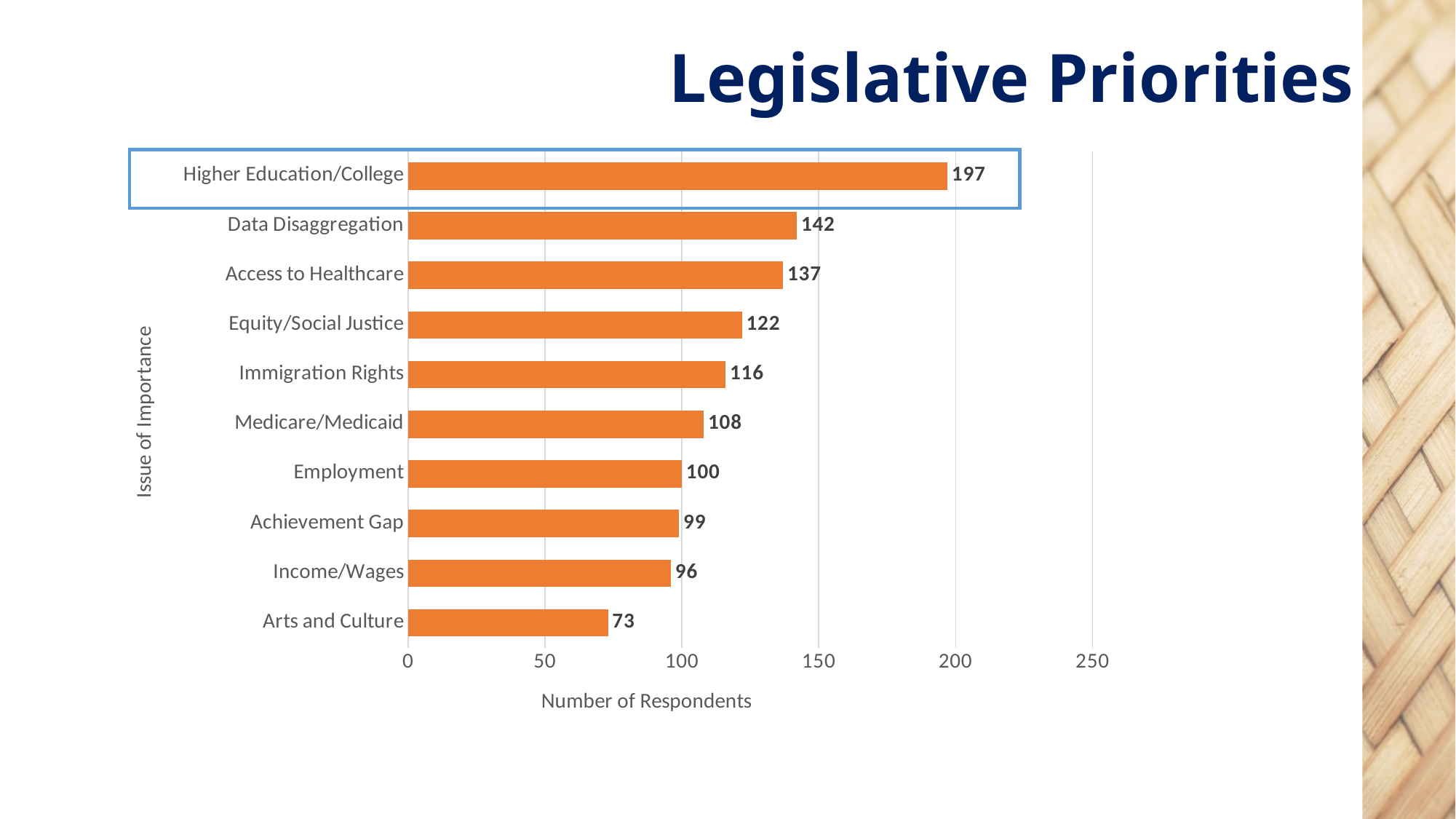
Which issue has the highest number of respondents? Higher Education/College Which has more respondents, Employment or Income/Wages? Employment How many respondents selected Higher Education/College as an issue of importance? 197 What is the difference in respondents between Higher Education/College and Data Disaggregation? 55 What is the number of respondents for Medicare/Medicaid? 108 Is the value for Data Disaggregation greater or less than 150? less How many issues are shown in the chart? 10 Which issue has the lowest number of respondents? Arts and Culture What type of chart is shown on the slide? Bar chart What is the label of the horizontal axis? Number of Respondents What is the number of respondents for Access to Healthcare? 137 What is the difference in respondents between Equity/Social Justice and Immigration Rights? 6